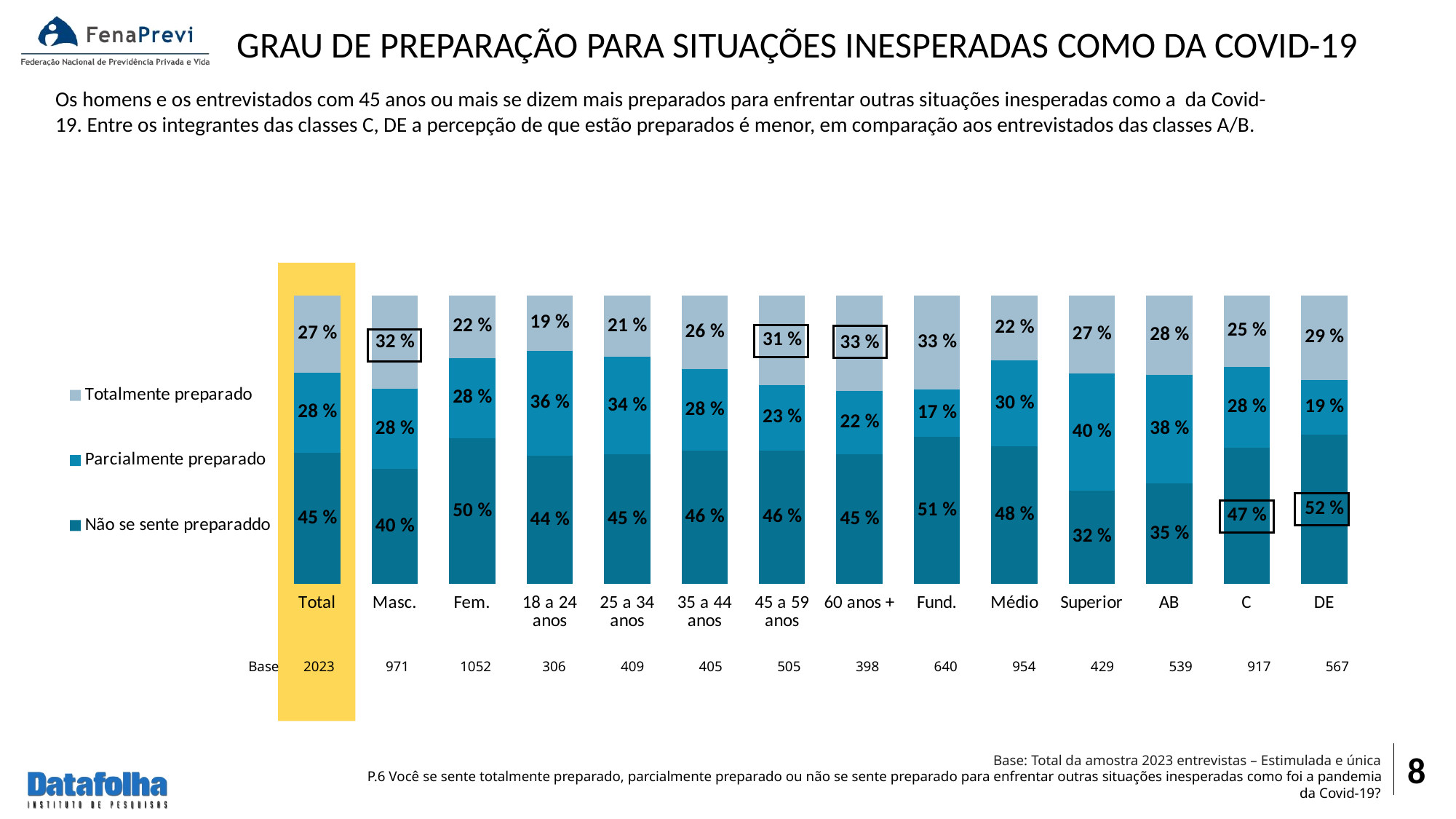
What is the total of the stacked bar for Total? 100 % What is the value of 'Parcialmente preparado' for Superior? 40 % Which category has the lowest value for 'Totalmente preparado'? 18 a 24 anos What type of chart is shown on the slide? Stacked bar chart Which category has the highest value for 'Não se sente preparado'? DE How many series does the legend list? 3 What is the base (number of interviews) shown for the Total category? 2023 How many categories are plotted along the x axis? 14 What is the difference between the 'Não se sente preparado' values for DE and AB? 17 % What is the value of 'Não se sente preparado' for Fem.? 50 % Which is larger: the 'Totalmente preparado' value for Masc. or for Fem.? Masc. What is the value of 'Totalmente preparado' for Masc.? 32 %